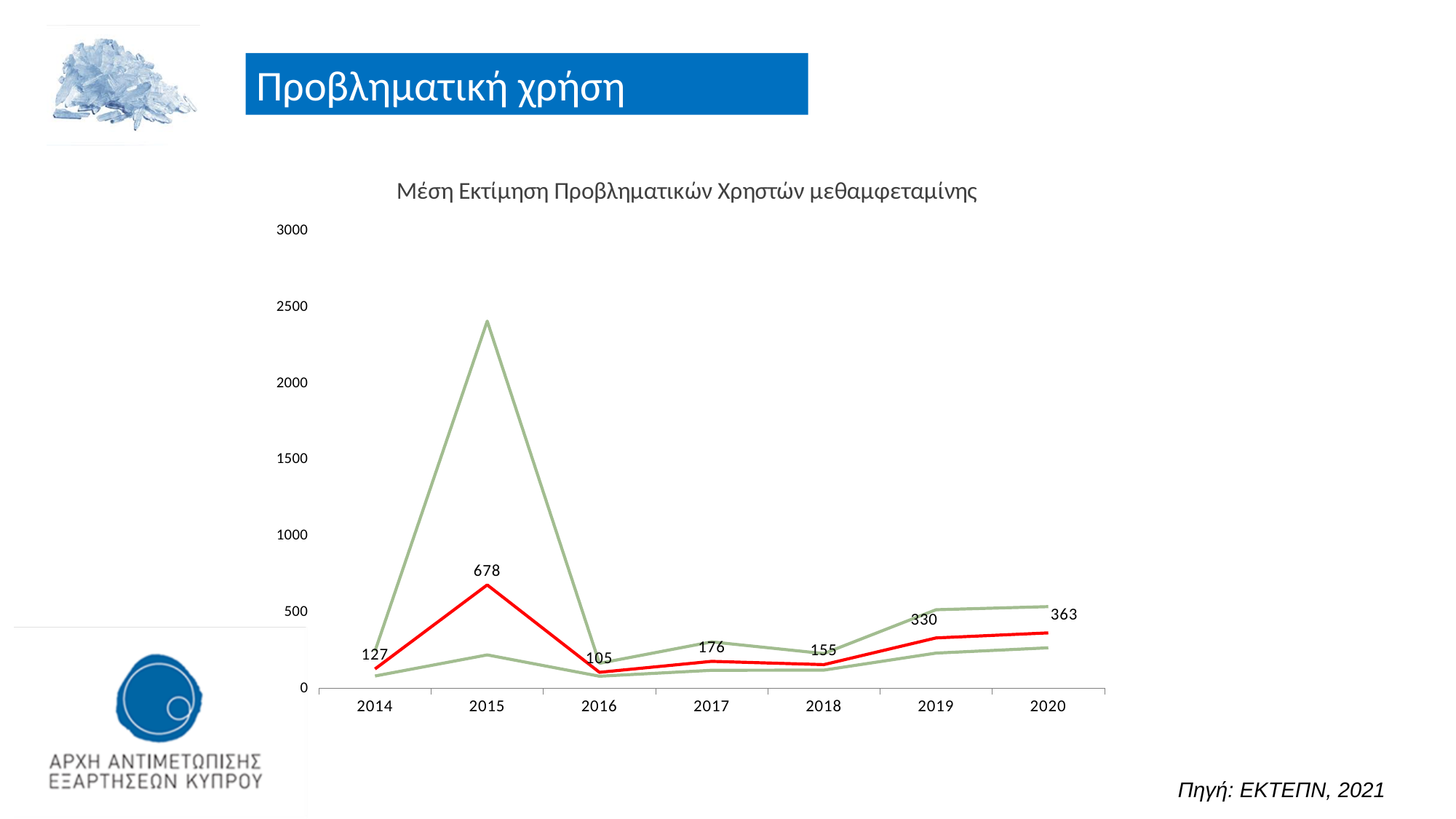
What is the value of the red line for 2015? 678 In which year does the red line reach its highest value? 2015 What kind of chart is shown on the slide? line chart Which year has the larger red-line value, 2017 or 2018? 2017 What is the value of the red line for 2020? 363 What is the difference between the red line's values for 2020 and 2019? 33 How many years are shown on the x axis? 7 Does the red line rise or fall from 2018 to 2019? rise In which year does the red line reach its lowest value? 2016 Is the value of the upper green line for 2015 greater or less than 2000? greater What is the difference between the red line's values for 2015 and 2016? 573 What is the value of the red line for 2014? 127